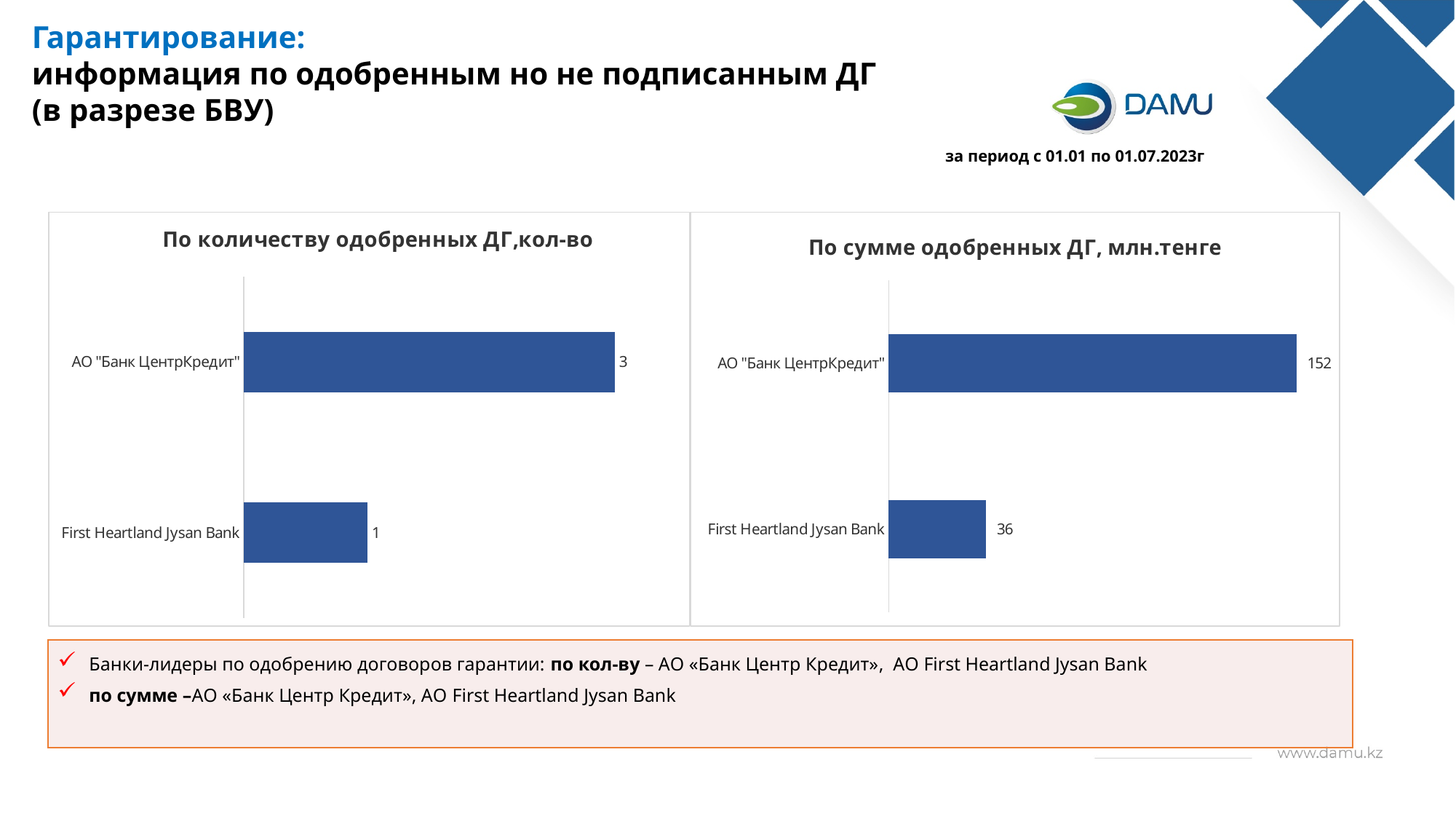
In the chart "По сумме одобренных ДГ, млн.тенге", what is the difference between АО "Банк ЦентрКредит" and First Heartland Jysan Bank? 116 In the chart "По сумме одобренных ДГ, млн.тенге", which is larger: the value for АО "Банк ЦентрКредит" or for First Heartland Jysan Bank? АО "Банк ЦентрКредит" How many banks are shown in the chart "По количеству одобренных ДГ,кол-во"? 2 In the chart "По количеству одобренных ДГ,кол-во", what is the difference between АО "Банк ЦентрКредит" and First Heartland Jysan Bank? 2 In the chart "По количеству одобренных ДГ,кол-во", what is the value for First Heartland Jysan Bank? 1 In the chart "По количеству одобренных ДГ,кол-во", what is the value for АО "Банк ЦентрКредит"? 3 In the chart "По сумме одобренных ДГ, млн.тенге", which bank has the highest value? АО "Банк ЦентрКредит" In the chart "По сумме одобренных ДГ, млн.тенге", what is the value for АО "Банк ЦентрКредит"? 152 What is the title of the left chart on the slide? По количеству одобренных ДГ,кол-во In the chart "По сумме одобренных ДГ, млн.тенге", what is the value for First Heartland Jysan Bank? 36 In the chart "По количеству одобренных ДГ,кол-во", which bank has the lowest value? First Heartland Jysan Bank What type of chart is "По сумме одобренных ДГ, млн.тенге"? Bar chart